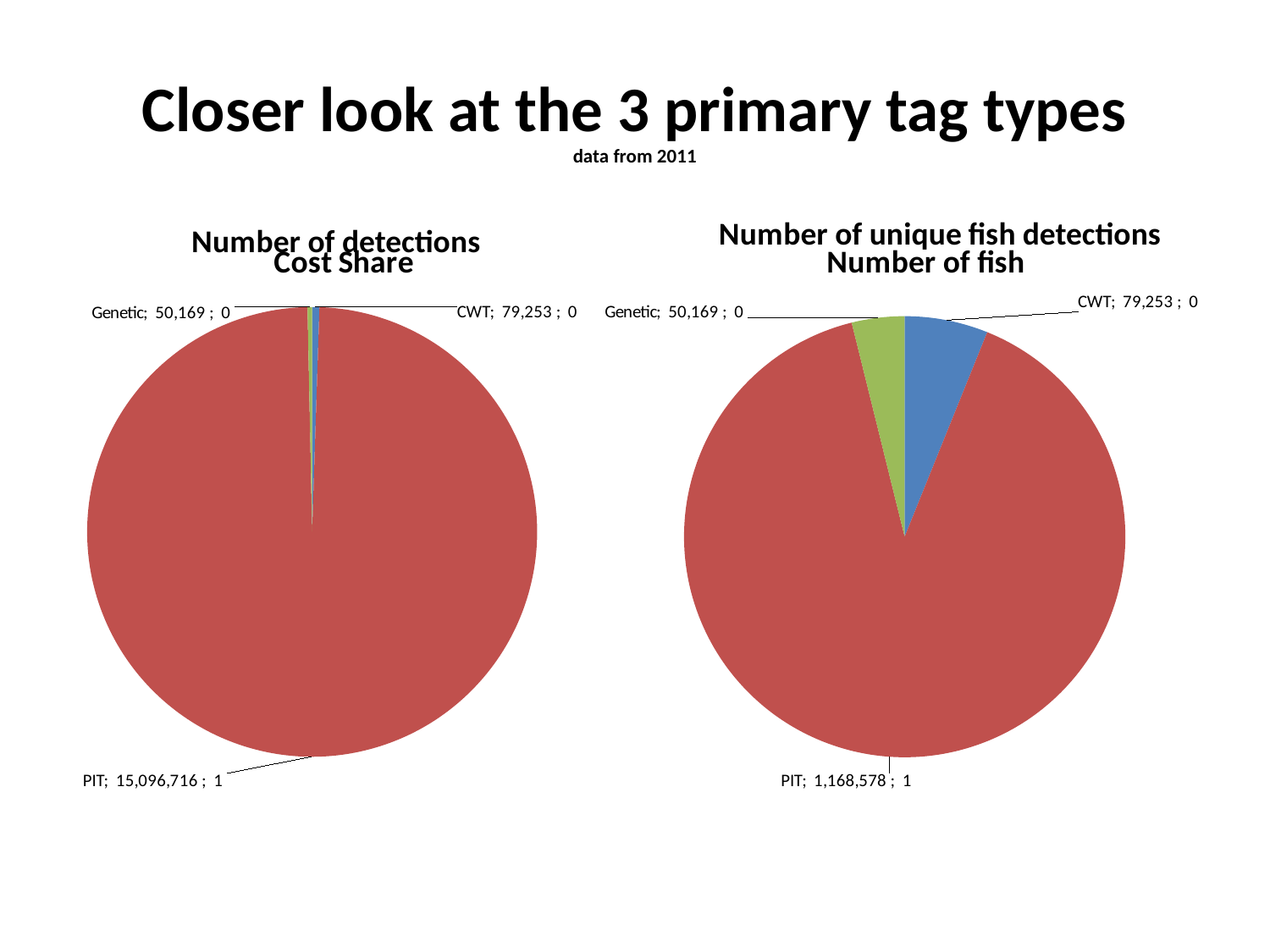
In the right pie chart (Number of unique fish detections), what is the difference between the PIT value and the CWT value? 1,089,325 In the left pie chart (Number of detections), what is the difference between the CWT value and the Genetic value? 29,084 In the left pie chart (Number of detections), what is the value for PIT? 15,096,716 In the right pie chart (Number of unique fish detections), which tag type has the largest slice? PIT In the right pie chart (Number of unique fish detections), which is larger, the CWT value or the Genetic value? CWT What kind of chart is used for Number of unique fish detections on the right? Pie chart In the right pie chart (Number of unique fish detections), what is the value for PIT? 1,168,578 How many tag types (slices) are shown in the left pie chart (Number of detections)? 3 What colour is the PIT slice in both pie charts? Red In the left pie chart (Number of detections), what is the value for Genetic? 50,169 In the left pie chart (Number of detections), what is the value for CWT? 79,253 In the left pie chart (Number of detections), which tag type has the smallest value? Genetic